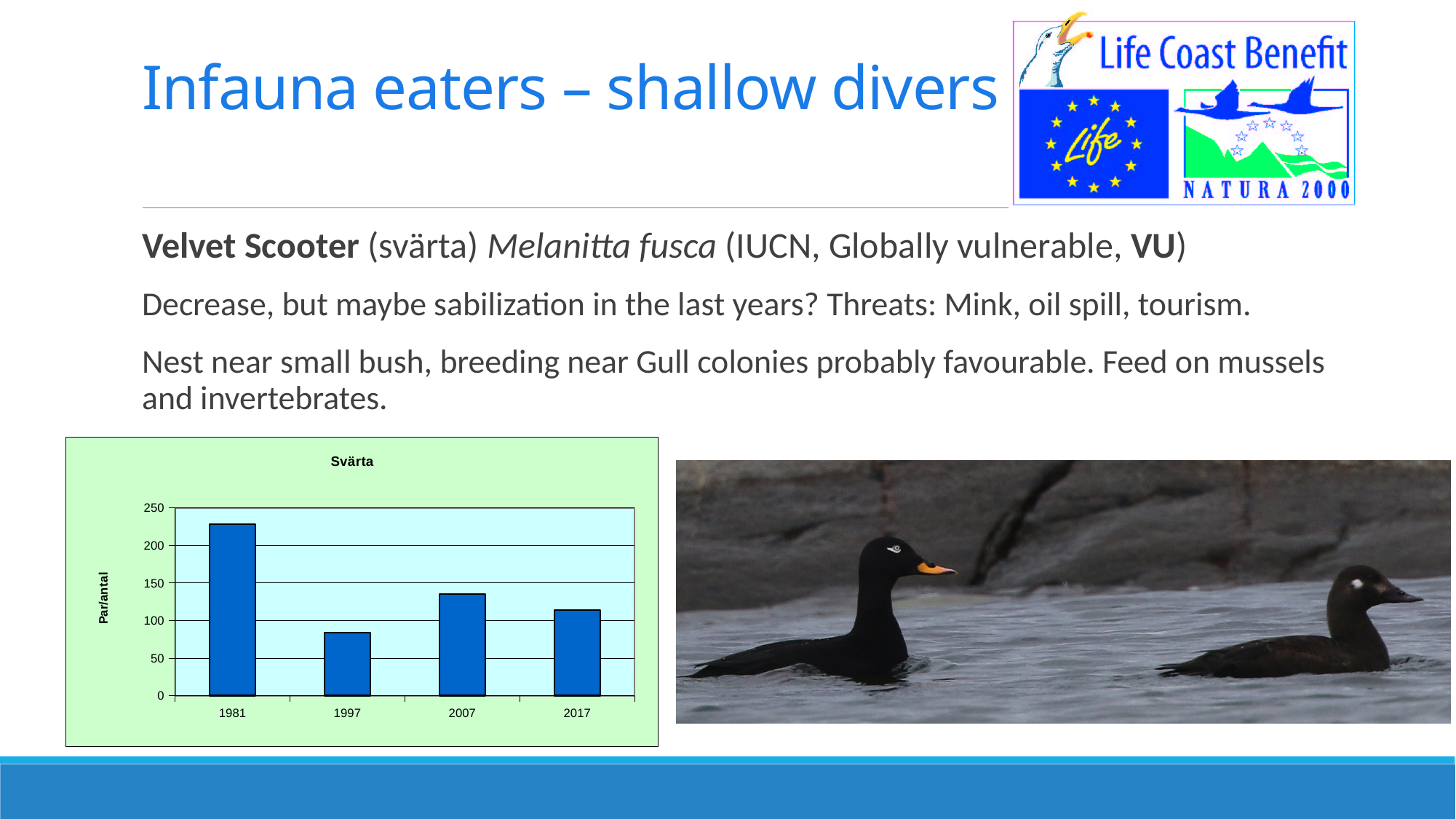
Is the value for 1981 greater or less than 200? greater Which is larger, the value for 2007 or the value for 2017? 2007 Does the value rise or fall from 1981 to 1997? fall What type of chart is shown on the slide? bar chart What is the title of the chart? Svärta What is the label on the y axis of the chart? Par/antal Is the value for 1997 greater or less than 100? less Is the value for 2007 greater or less than 150? less How many years are shown on the x axis of the chart? 4 Which year has the lowest value in the chart? 1997 Which year has the highest value in the chart? 1981